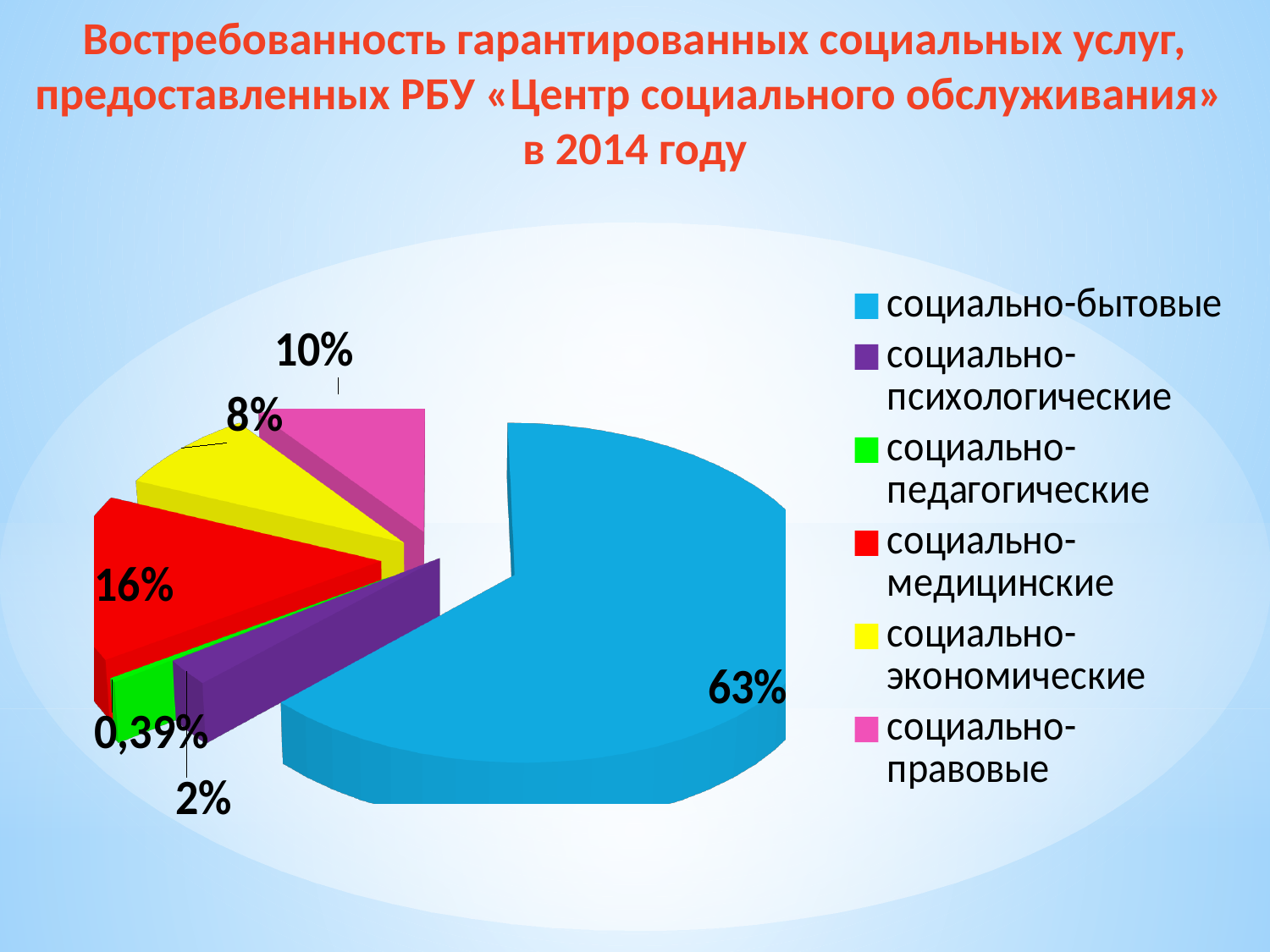
Which is larger, the share for социально-медицинские or for социально-правовые? социально-медицинские What colour is the slice for социально-экономические? yellow What is the difference between the shares for социально-бытовые and социально-медицинские? 47% What share of the pie is labelled for социально-педагогические? 0,39% What share of the pie is labelled for социально-правовые? 10% What share of the pie is labelled for социально-медицинские? 16% Which category has the largest slice of the pie? социально-бытовые What share of the pie is labelled for социально-бытовые? 63% What type of chart is shown on the slide? pie chart Which category has the smallest slice of the pie? социально-педагогические How many categories does the legend list? 6 What share of the pie is labelled for социально-экономические? 8%